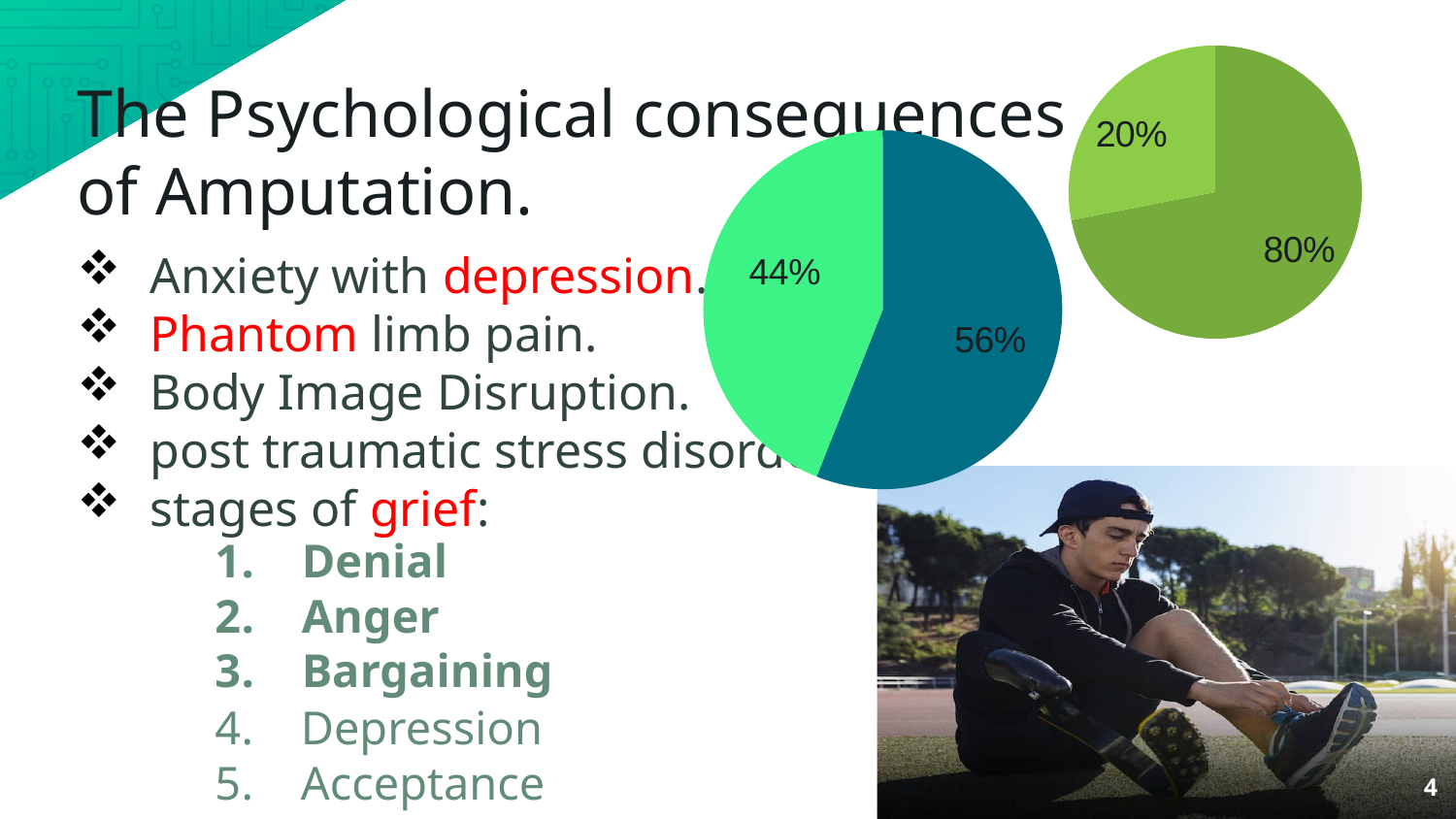
In the smaller pie chart in the top-right corner, what value is shown on the larger, darker green slice? 80% In the larger pie chart in the centre of the slide, what is the difference between the two slice values? 12% How many slices does the larger pie chart in the centre of the slide have? 2 In the larger pie chart in the centre of the slide, what value is shown on the dark teal slice? 56% What kind of chart is the larger chart in the centre of the slide? pie chart What kind of chart is the smaller chart in the top-right corner of the slide? pie chart How many slices does the smaller pie chart in the top-right corner have? 2 In the larger pie chart in the centre of the slide, which slice is the largest, the dark teal one or the light green one? the dark teal slice In the smaller pie chart in the top-right corner, what is the difference between the two slice values? 60% In the smaller pie chart in the top-right corner, what value is shown on the smaller, lighter green slice? 20% In the smaller pie chart in the top-right corner, which slice is the smallest, the lighter green one or the darker green one? the lighter green slice In the larger pie chart in the centre of the slide, what value is shown on the light green slice? 44%